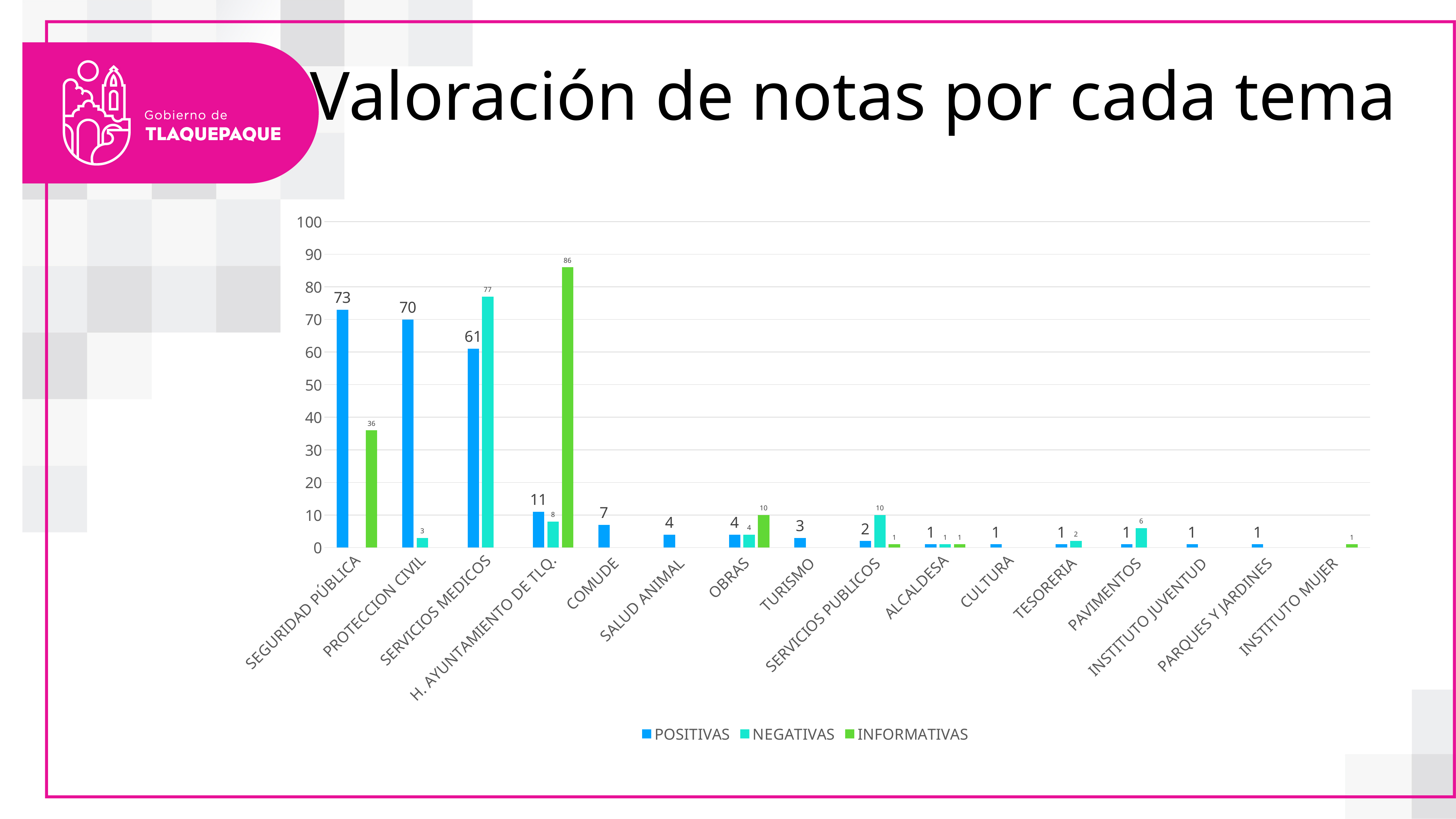
What is the title of the slide? Valoración de notas por cada tema How many series does the legend list? 3 What is the INFORMATIVAS value for SEGURIDAD PÚBLICA? 36 What is the POSITIVAS value for SEGURIDAD PÚBLICA? 73 For SERVICIOS MEDICOS, which is larger: the POSITIVAS value or the NEGATIVAS value? NEGATIVAS What is the difference between the POSITIVAS values for SEGURIDAD PÚBLICA and PROTECCION CIVIL? 3 Which category has the highest POSITIVAS value? SEGURIDAD PÚBLICA Which category has the highest INFORMATIVAS value? H. AYUNTAMIENTO DE TLQ. What kind of chart is shown on the slide? Bar chart How many categories are shown on the x axis? 16 What is the NEGATIVAS value for SERVICIOS MEDICOS? 77 What is the INFORMATIVAS value for H. AYUNTAMIENTO DE TLQ.? 86